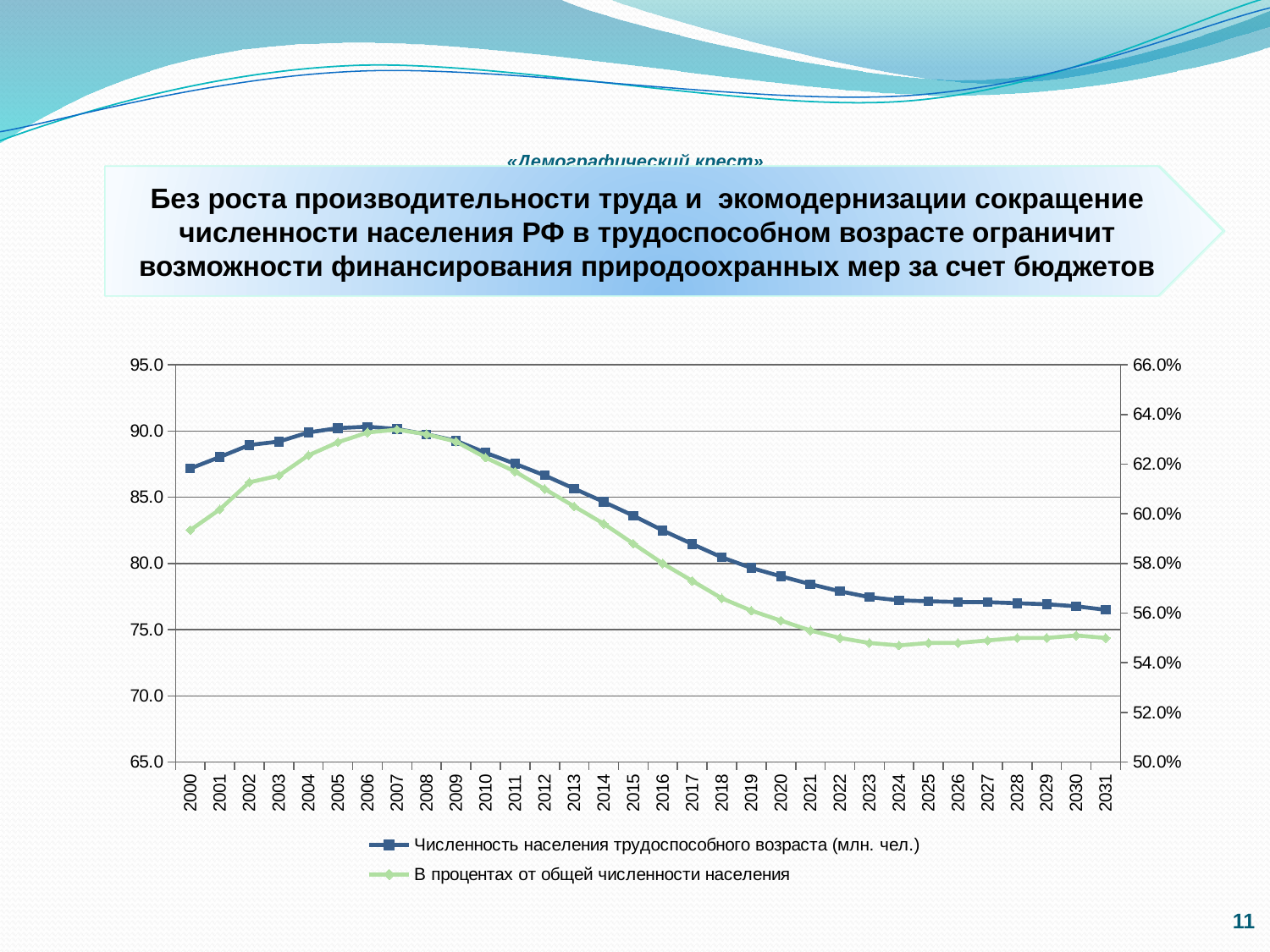
Is the value of 'В процентах от общей численности населения' for 2000 greater or less than 60.0%? less Which is larger for 'Численность населения трудоспособного возраста (млн. чел.)': the value for 2000 or the value for 2031? 2000 What is the first year shown on the x axis? 2000 What kind of chart is shown on the slide? line chart Do the values of 'Численность населения трудоспособного возраста (млн. чел.)' rise or fall from 2007 to 2031? fall How many series does the legend list? 2 Is the value of 'Численность населения трудоспособного возраста (млн. чел.)' for 2000 greater or less than 85.0? greater Is the value of 'В процентах от общей численности населения' for 2031 greater or less than 56.0%? less What is the last year shown on the x axis? 2031 How many years are plotted along the x axis? 32 Which year has the lowest value for 'Численность населения трудоспособного возраста (млн. чел.)'? 2031